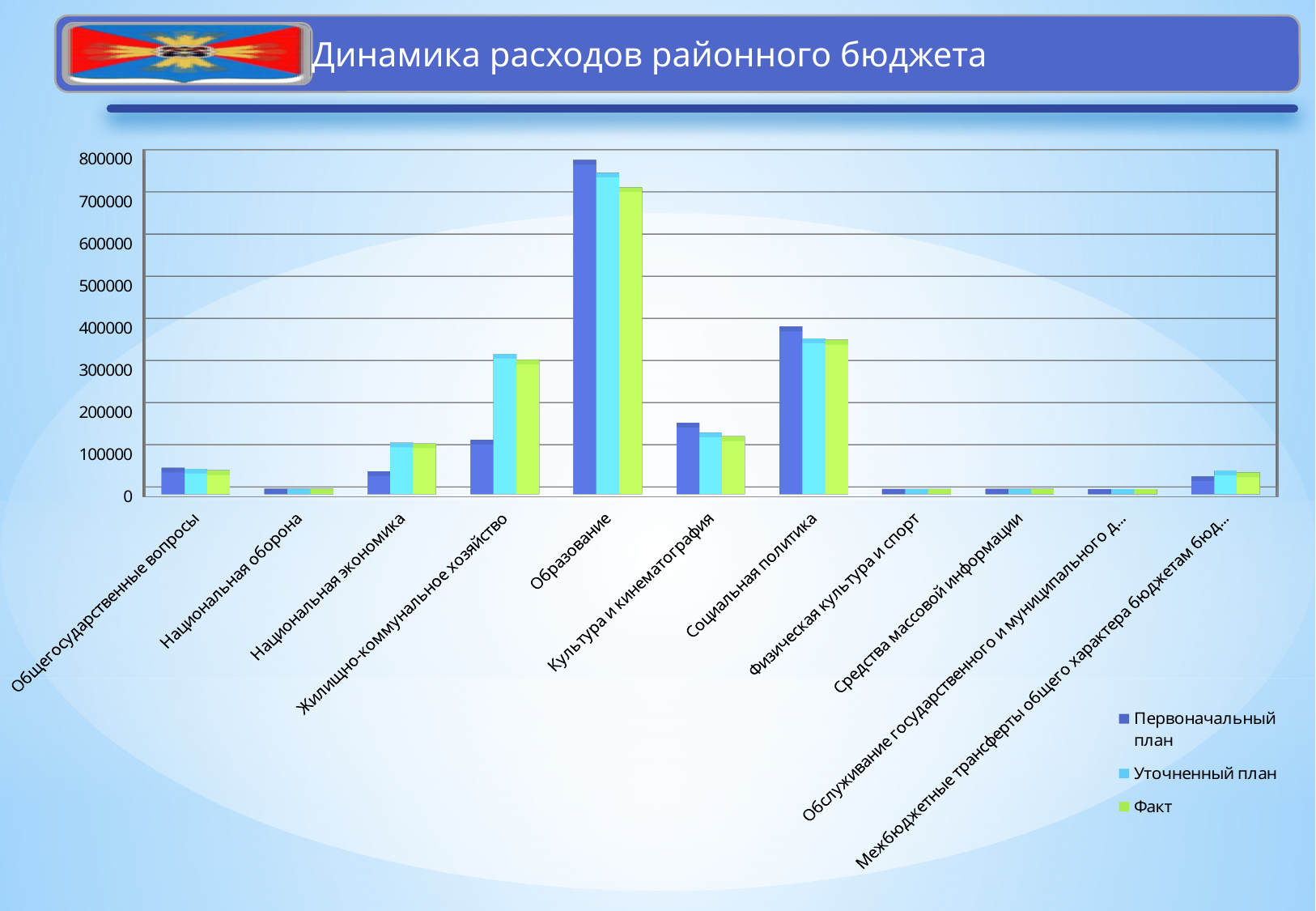
Is the Первоначальный план value for Образование greater or less than 700000? greater Which category has the highest value for Первоначальный план? Образование What is the title of the slide? Динамика расходов районного бюджета Is the Первоначальный план value for Культура и кинематография greater or less than 100000? greater How many categories are shown on the x axis? 11 How many series does the legend list? 3 What kind of chart is shown on the slide? Bar chart For Образование, which is larger: Первоначальный план or Факт? Первоначальный план For Жилищно-коммунальное хозяйство, which is larger: Первоначальный план or Уточненный план? Уточненный план Is the Уточненный план value for Жилищно-коммунальное хозяйство greater or less than 300000? greater Which category has the highest value for Факт? Образование